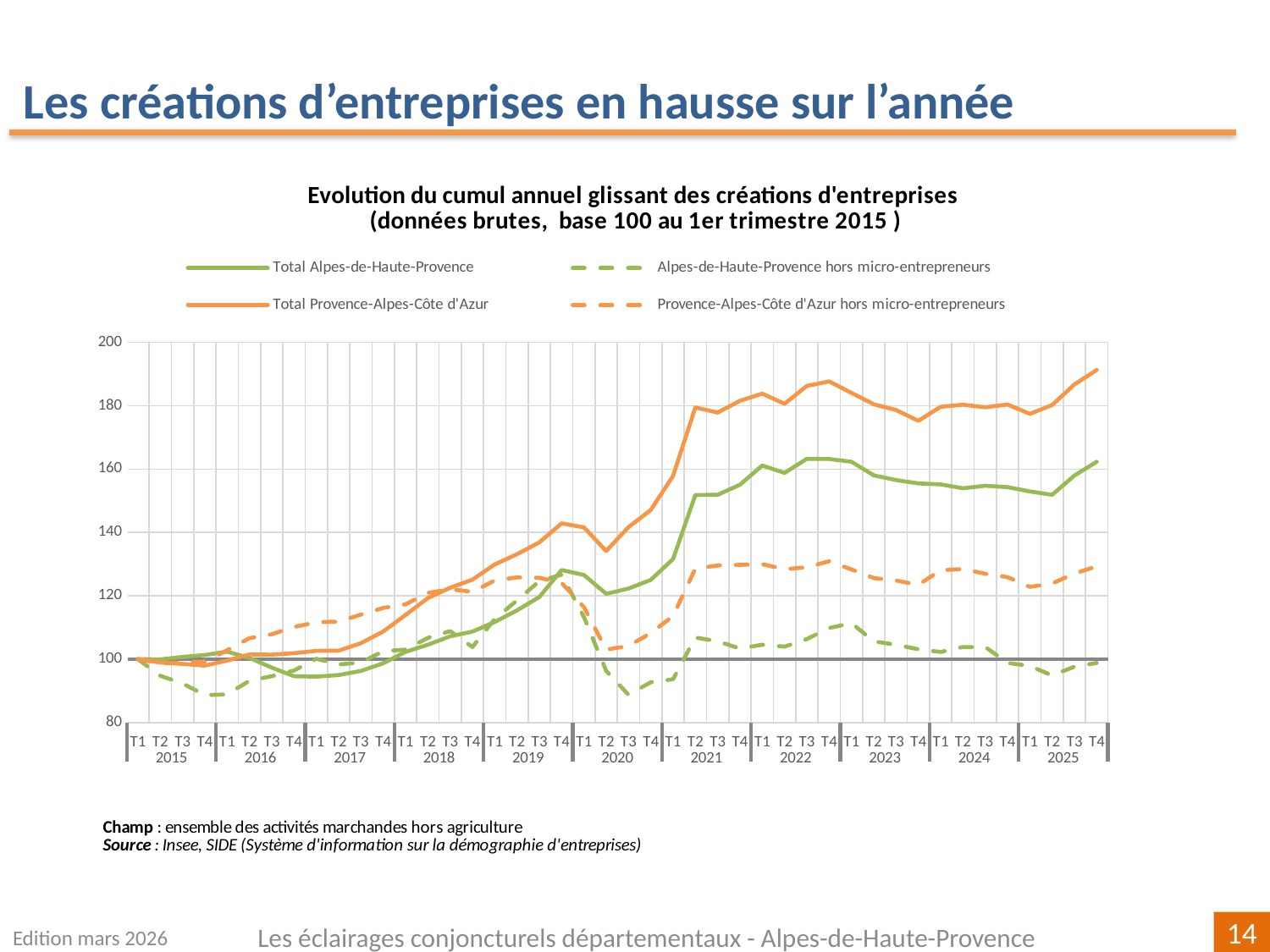
Is the value for Alpes-de-Haute-Provence hors micro-entrepreneurs at T3 2020 greater or less than 100? less Is the value for Total Alpes-de-Haute-Provence at T4 2025 greater or less than 140? greater At T4 2025, which is higher: Alpes-de-Haute-Provence hors micro-entrepreneurs or Provence-Alpes-Côte d'Azur hors micro-entrepreneurs? Provence-Alpes-Côte d'Azur hors micro-entrepreneurs Is the value for Alpes-de-Haute-Provence hors micro-entrepreneurs at T1 2016 greater or less than 100? less Does the Total Provence-Alpes-Côte d'Azur series rise or fall overall from T1 2015 to T4 2025? rise What type of chart is shown on the slide? line chart At T4 2025, which is higher: Total Provence-Alpes-Côte d'Azur or Total Alpes-de-Haute-Provence? Total Provence-Alpes-Côte d'Azur How many series does the legend list? 4 How many years are shown on the x axis? 11 Which series reaches the highest value on the chart? Total Provence-Alpes-Côte d'Azur